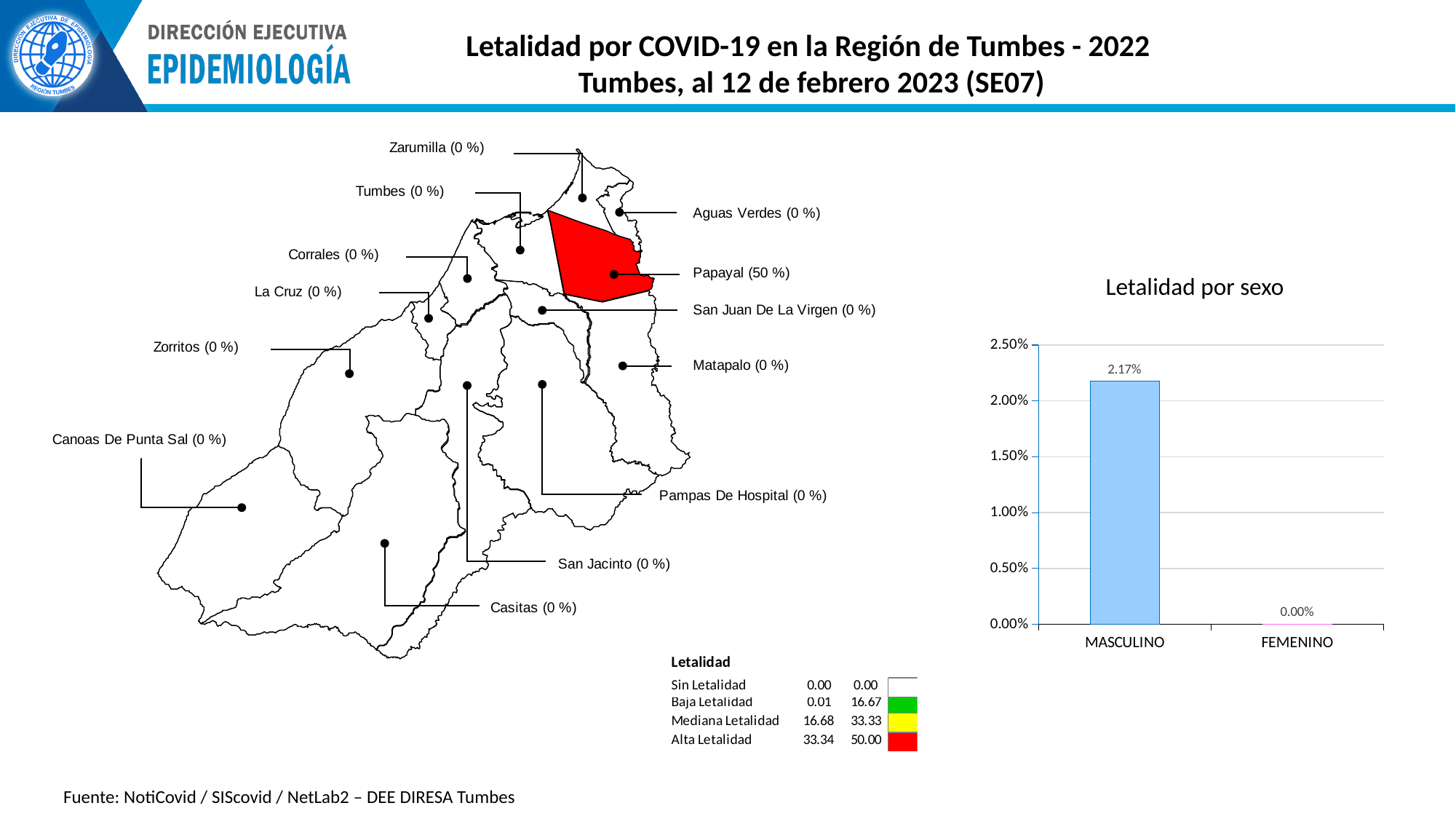
On the map, which district is shaded red? Papayal In the 'Letalidad por sexo' chart, which category has the highest value? MASCULINO In the 'Letalidad por sexo' chart, what is the highest value shown on the y axis? 2.50% In the 'Letalidad por sexo' chart, which is larger, the value for MASCULINO or FEMENINO? MASCULINO In the 'Letalidad por sexo' chart, which category has the lowest value? FEMENINO What kind of chart is 'Letalidad por sexo'? bar chart In the 'Letalidad por sexo' chart, what is the value for FEMENINO? 0.00% In the 'Letalidad por sexo' chart, is the value for MASCULINO greater or less than 2.00%? greater On the map, what is the lethality value shown for Papayal? 50 % In the 'Letalidad por sexo' chart, what is the value for MASCULINO? 2.17% In the 'Letalidad por sexo' chart, what is the difference between the MASCULINO and FEMENINO values? 2.17% In the 'Letalidad por sexo' chart, how many categories are shown on the x axis? 2